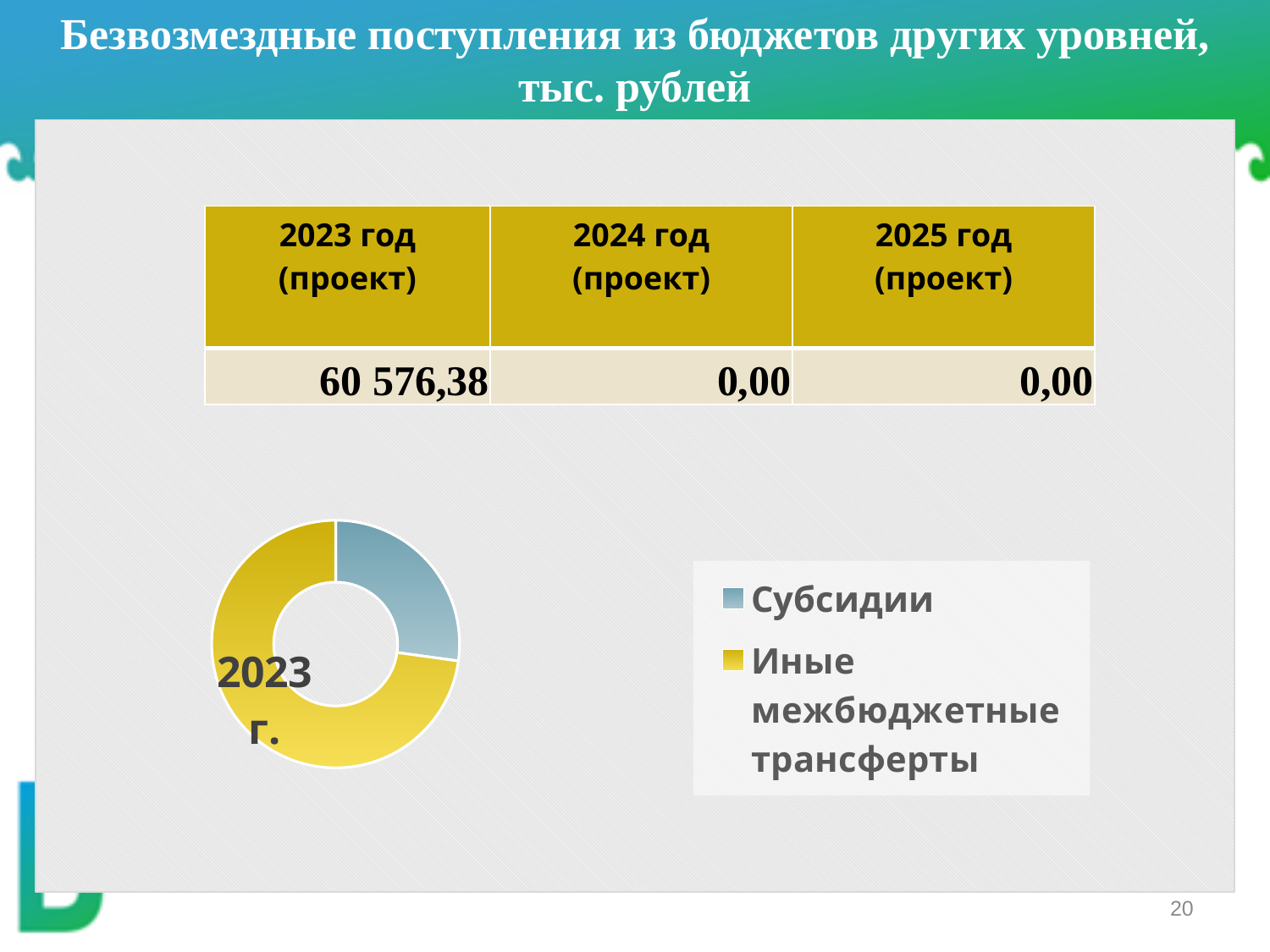
Which category takes the smallest share of the doughnut chart? Субсидии What colour represents Субсидии in the doughnut chart? Blue Which category takes the largest share of the doughnut chart? Иные межбюджетные трансферты Which year does the doughnut chart refer to, according to the label next to it? 2023 г. How many categories does the doughnut chart show? 2 Which is larger in the doughnut chart: Субсидии or Иные межбюджетные трансферты? Иные межбюджетные трансферты How many entries does the legend of the doughnut chart list? 2 What kind of chart is shown on the slide? Doughnut (pie) chart